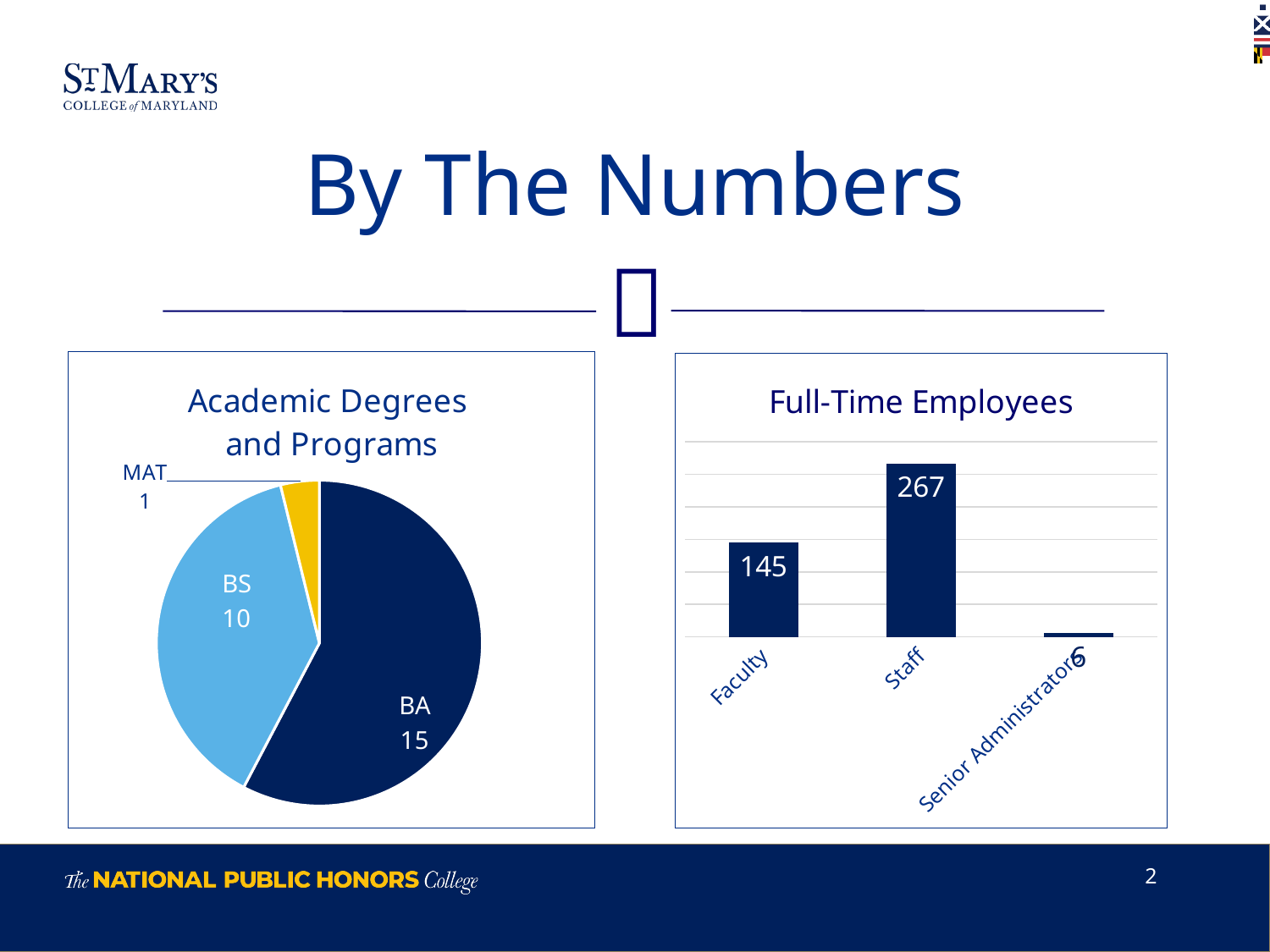
In the Full-Time Employees chart, what is the value for Staff? 267 In the Academic Degrees and Programs chart, which category has the largest slice? BA In the Full-Time Employees chart, what is the difference between Staff and Faculty? 122 In the Academic Degrees and Programs chart, which category has the smallest slice? MAT In the Academic Degrees and Programs chart, what is the value for MAT? 1 In the Academic Degrees and Programs chart, what is the difference between the BA and BS values? 5 How many categories does the Full-Time Employees chart show? 3 In the Full-Time Employees chart, how many Faculty are shown? 145 What kind of chart is the Academic Degrees and Programs chart? Pie chart In the Academic Degrees and Programs chart, what is the value for BS? 10 In the Academic Degrees and Programs chart, how many BA programs are shown? 15 In the Full-Time Employees chart, what is the value for Senior Administrators? 6